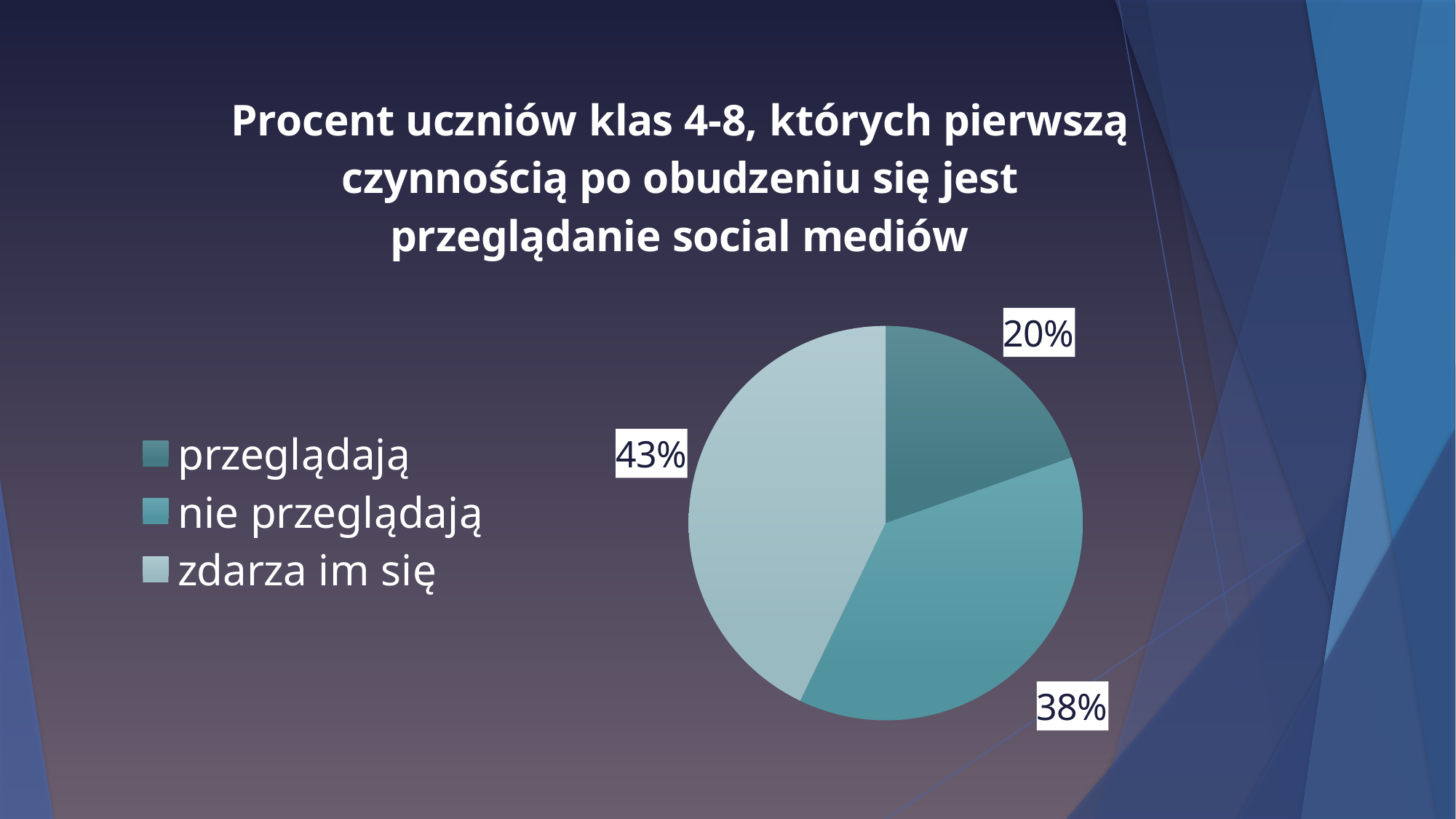
What percentage is shown for the "nie przeglądają" slice? 38% Which category has the smallest slice of the pie? przeglądają Which category has the largest slice of the pie? zdarza im się What percentage is shown for the "zdarza im się" slice? 43% Which is larger: the slice for "nie przeglądają" or the slice for "przeglądają"? nie przeglądają What kind of chart is shown on the slide? pie chart What is the difference in percentage points between "nie przeglądają" and "przeglądają"? 18 How many slices does the pie chart have? 3 What is the title of the chart? Procent uczniów klas 4-8, których pierwszą czynnością po obudzeniu się jest przeglądanie social mediów What share of the pie does the "zdarza im się" slice represent? 43% What percentage of the pie chart is labelled for "przeglądają"? 20% What is the difference in percentage points between "zdarza im się" and "przeglądają"? 23